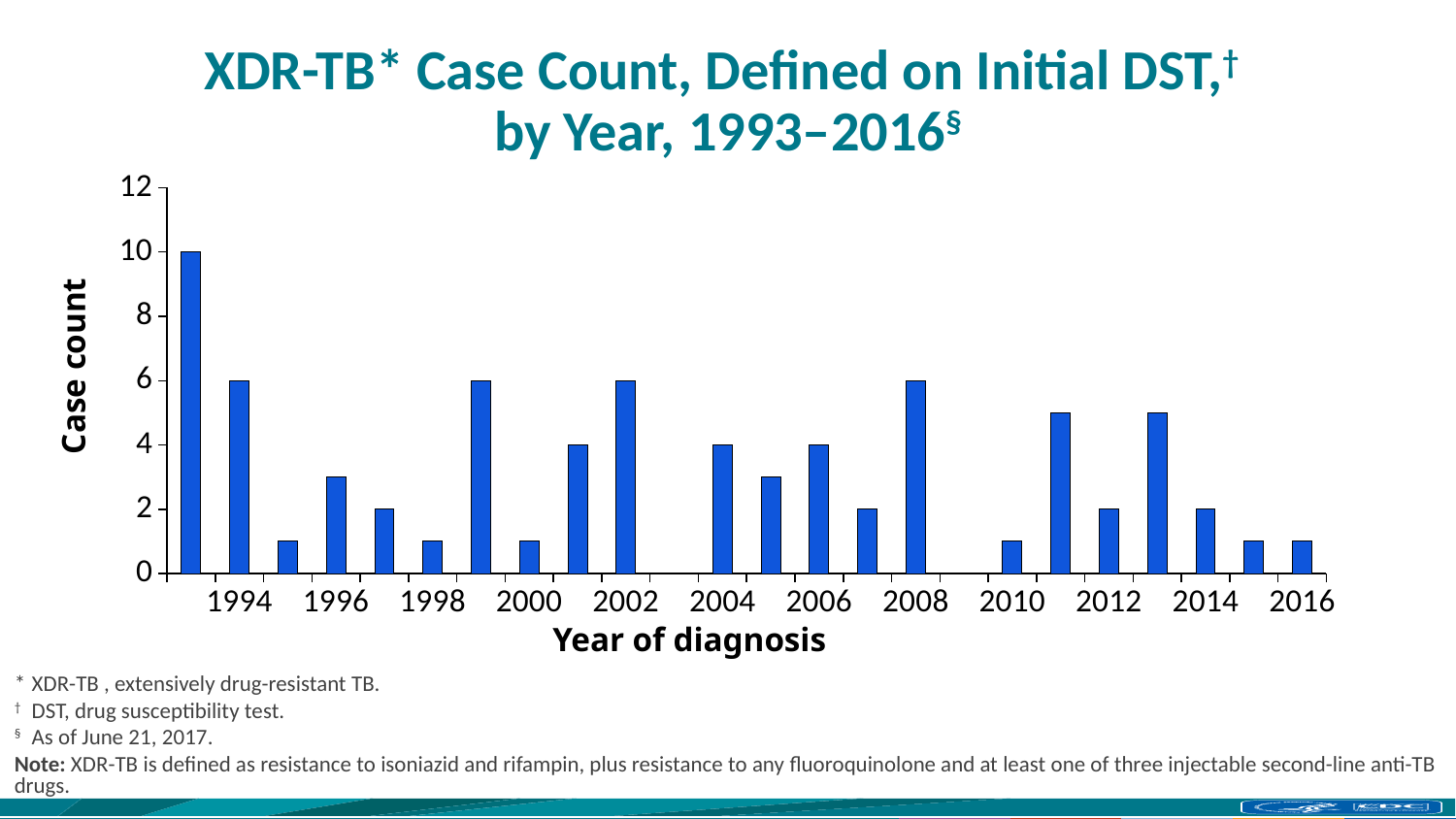
Is the case count for 2011 greater or less than 4? greater Which year has the larger case count, 2001 or 2012? 2001 What is the case count for 1994? 6 What is the label of the x axis? Year of diagnosis What type of chart is shown on the slide? bar chart Is the case count for 1996 greater or less than 4? less What is the difference between the case counts for 1993 and 1994? 4 What is the case count for 2008? 6 What is the case count for 2012? 2 Which year has the highest case count? 1993 What is the case count for 1993? 10 Do the case counts rise or fall from 1993 to 1995? fall